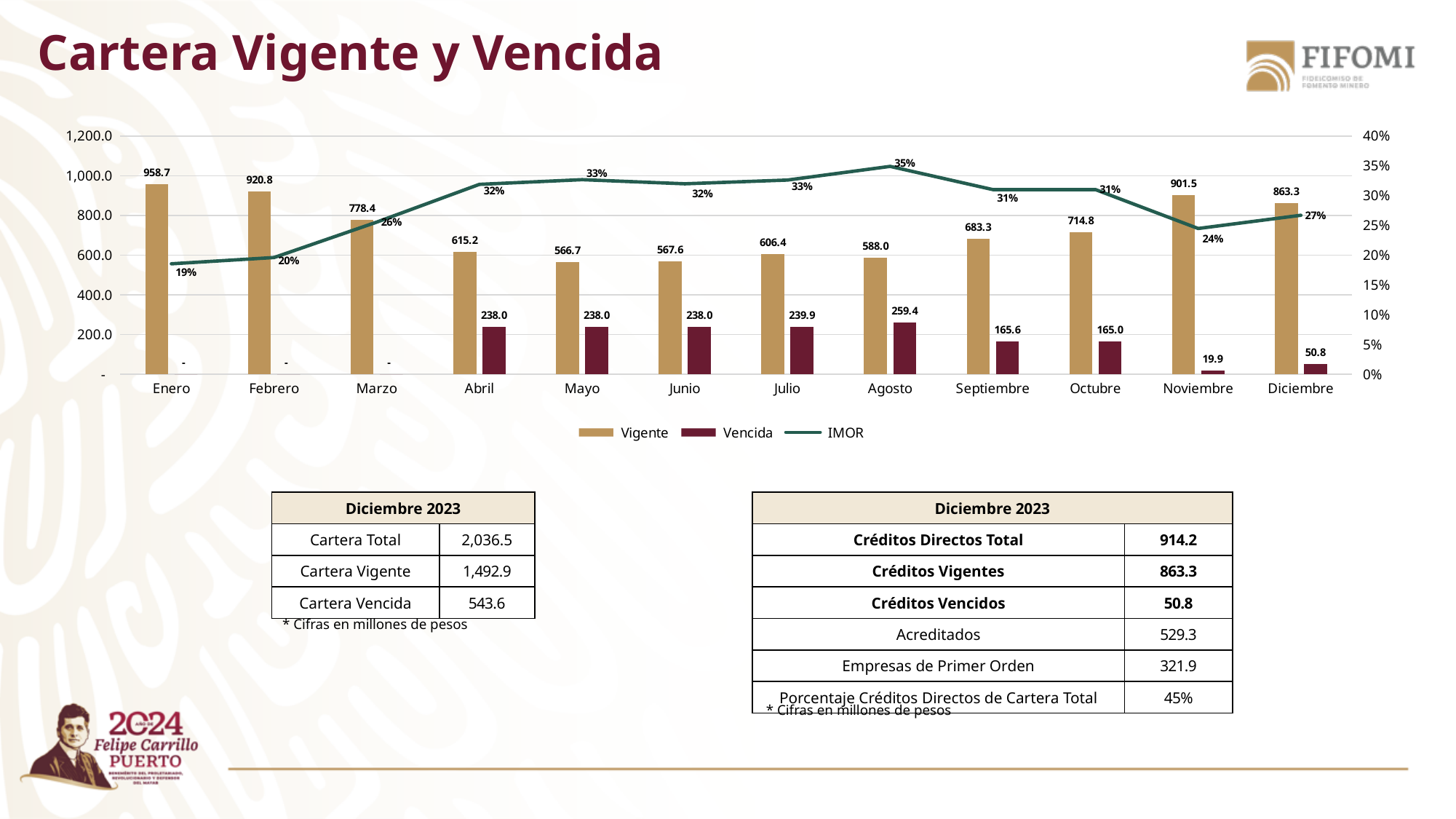
What is the Vencida value for Agosto? 259.4 What is the Vigente value for Enero? 958.7 What is the difference between the Vigente values for Enero and Diciembre? 95.4 What kind of chart is shown on the slide? Combined bar and line chart What is the IMOR value for Noviembre? 24% How many series does the legend list? 3 Which is larger, the Vigente value for Septiembre or for Octubre? Octubre Which month has the lowest Vencida value among the months with a labeled Vencida bar? Noviembre Is the Vigente value for Marzo greater or less than 800.0? less How many months are shown on the x axis? 12 Which month has the highest IMOR value? Agosto Which month has the highest Vigente value? Enero